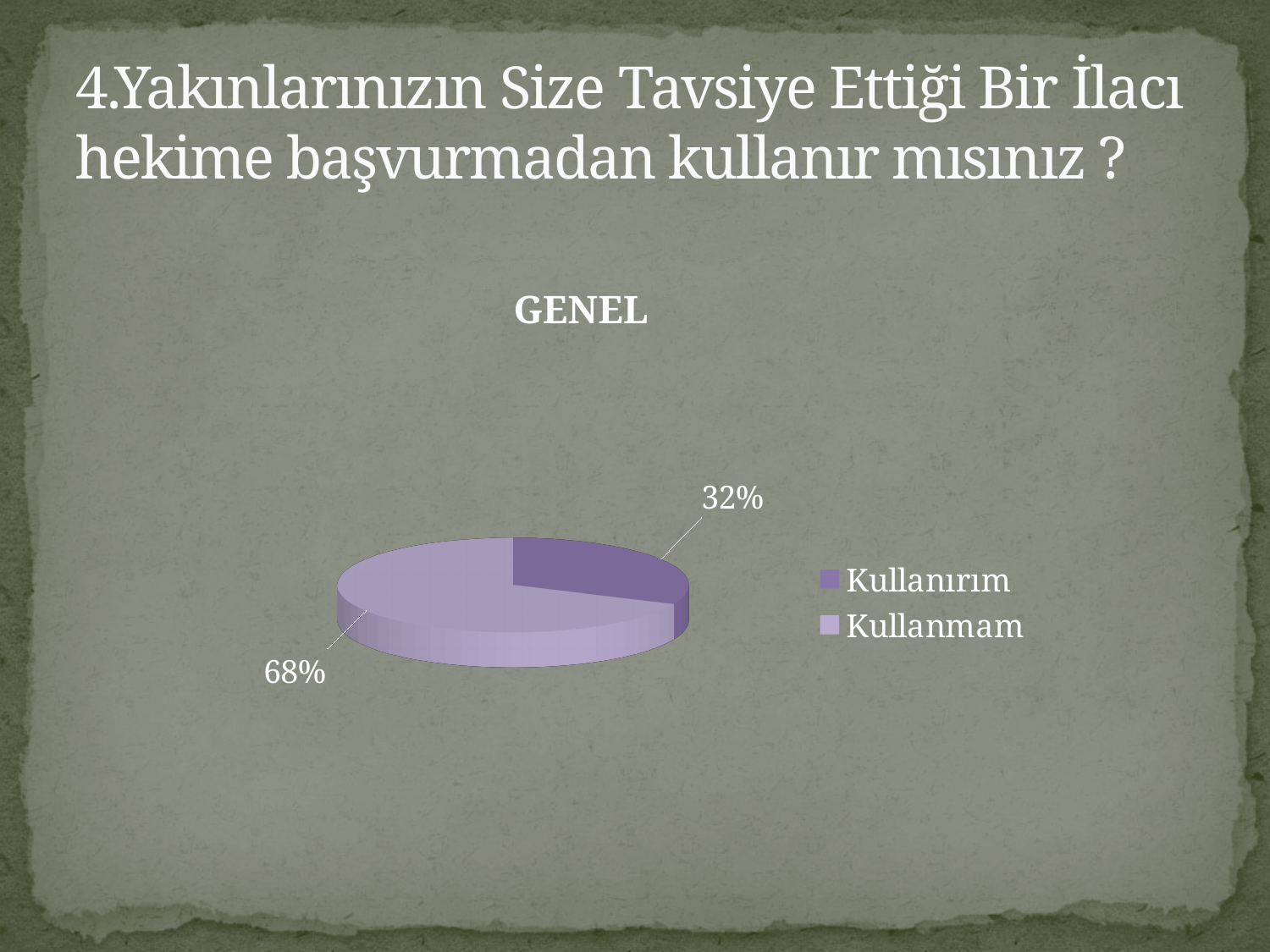
What is the difference in percentage points between the Kullanmam and Kullanırım slices? 36 How many entries does the legend list? 2 What percentage of the pie is labelled Kullanırım? 32% What type of chart is shown on the slide? pie chart How many slices does the pie chart have? 2 Which legend entry is shown in the darker purple colour? Kullanırım What is the title of the chart? GENEL Which slice of the pie is the smallest? Kullanırım What percentage of the pie is labelled Kullanmam? 68% Which slice of the pie is the largest? Kullanmam Which is larger, the Kullanırım slice or the Kullanmam slice? Kullanmam What share of the pie does the Kullanmam slice represent? 68%